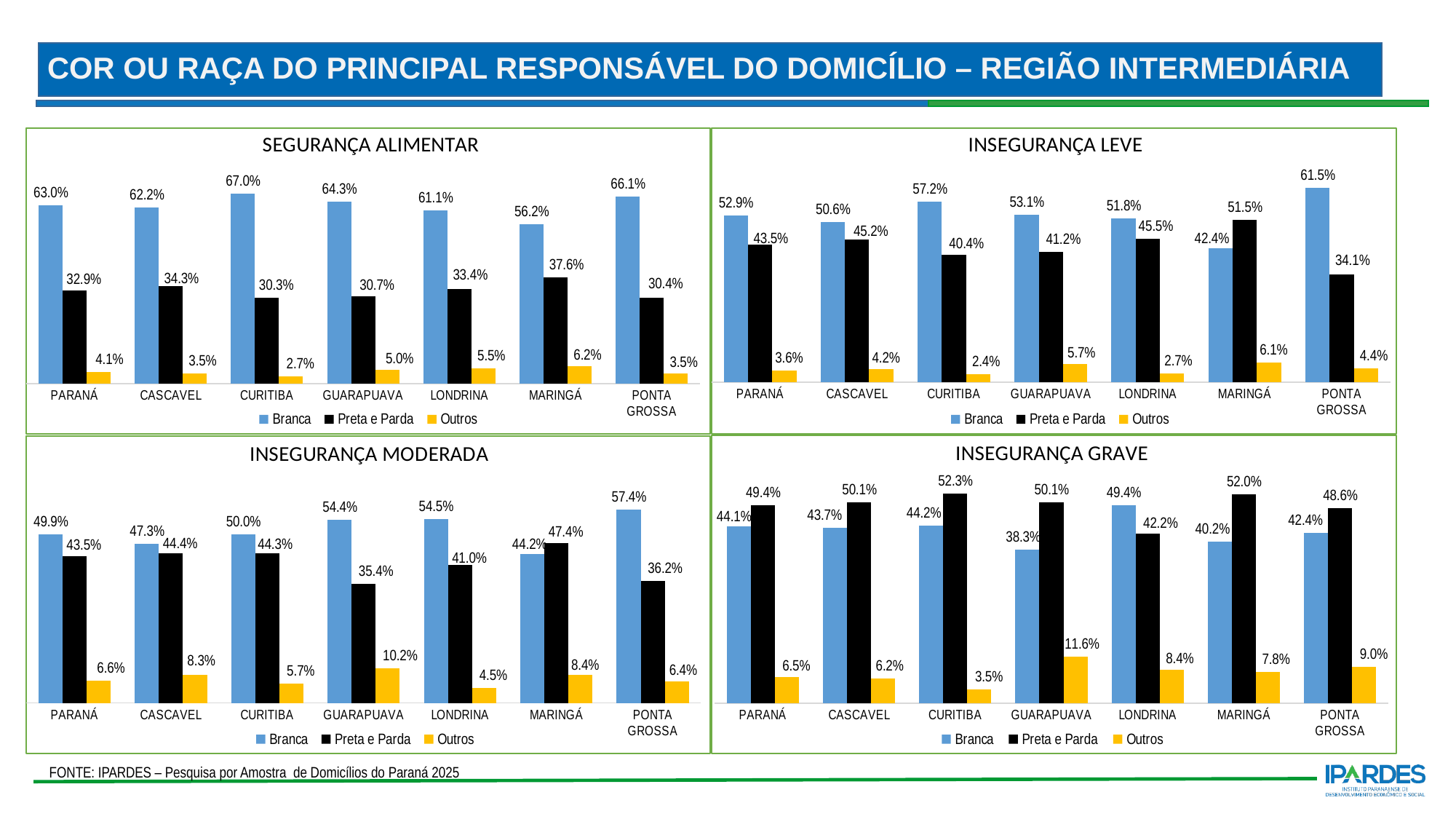
In the INSEGURANÇA GRAVE chart, which category has the lowest value for Branca? GUARAPUAVA In the INSEGURANÇA GRAVE chart, what is the difference between Preta e Parda and Branca in CURITIBA? 8.1% In the INSEGURANÇA MODERADA chart, what is the value for Outros in GUARAPUAVA? 10.2% In the INSEGURANÇA LEVE chart, what is the difference between Branca and Preta e Parda in PONTA GROSSA? 27.4% In the SEGURANÇA ALIMENTAR chart, which category has the lowest value for Outros? CURITIBA In the INSEGURANÇA LEVE chart, what is the value for Preta e Parda in LONDRINA? 45.5% In the SEGURANÇA ALIMENTAR chart, what is the value for Branca in CURITIBA? 67.0% In the SEGURANÇA ALIMENTAR chart, which category has the highest value for Preta e Parda? MARINGÁ In the INSEGURANÇA LEVE chart, which is larger in MARINGÁ, Branca or Preta e Parda? Preta e Parda In the INSEGURANÇA MODERADA chart, which category has the highest value for Branca? PONTA GROSSA How many series does the legend of the INSEGURANÇA GRAVE chart list? 3 How many categories are shown on the x axis of the SEGURANÇA ALIMENTAR chart? 7